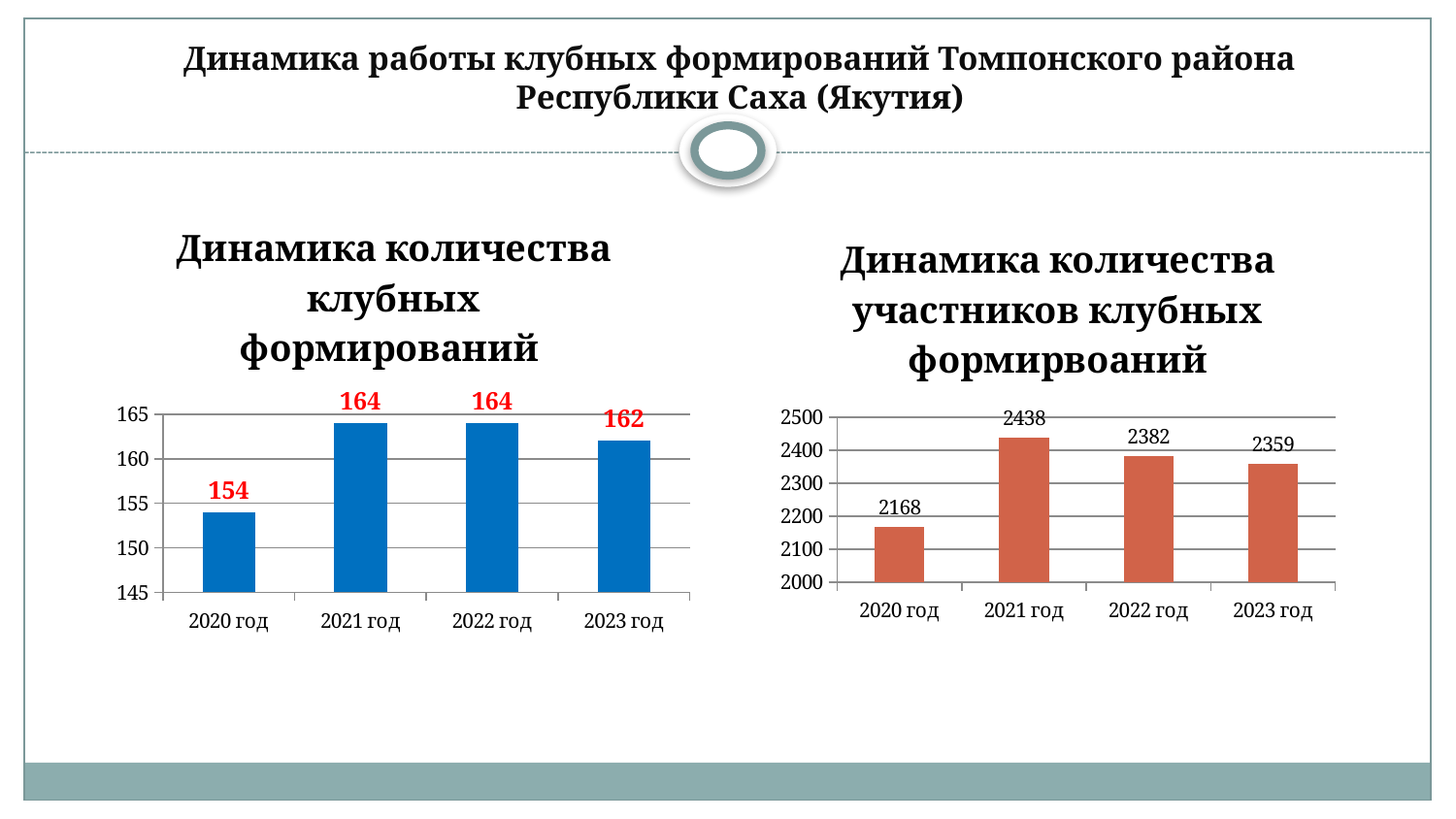
In the right chart (Динамика количества участников клубных формирвоаний), what is the value for 2020 год? 2168 What type of chart is the right chart (Динамика количества участников клубных формирвоаний)? bar chart In the left chart (Динамика количества клубных формирований), what is the difference between the values for 2021 год and 2020 год? 10 In the left chart (Динамика количества клубных формирований), which year has the lowest value? 2020 год In the right chart (Динамика количества участников клубных формирвоаний), is the value for 2022 год larger or smaller than the value for 2023 год? larger In the left chart (Динамика количества клубных формирований), what is the value for 2023 год? 162 In the left chart (Динамика количества клубных формирований), what is the value for 2020 год? 154 In the right chart (Динамика количества участников клубных формирвоаний), which year has the highest value? 2021 год In the right chart (Динамика количества участников клубных формирвоаний), what is the difference between the values for 2022 год and 2023 год? 23 In the right chart (Динамика количества участников клубных формирвоаний), do the values rise or fall from 2021 год to 2023 год? fall In the left chart (Динамика количества клубных формирований), how many years are shown? 4 In the right chart (Динамика количества участников клубных формирвоаний), what is the value for 2021 год? 2438